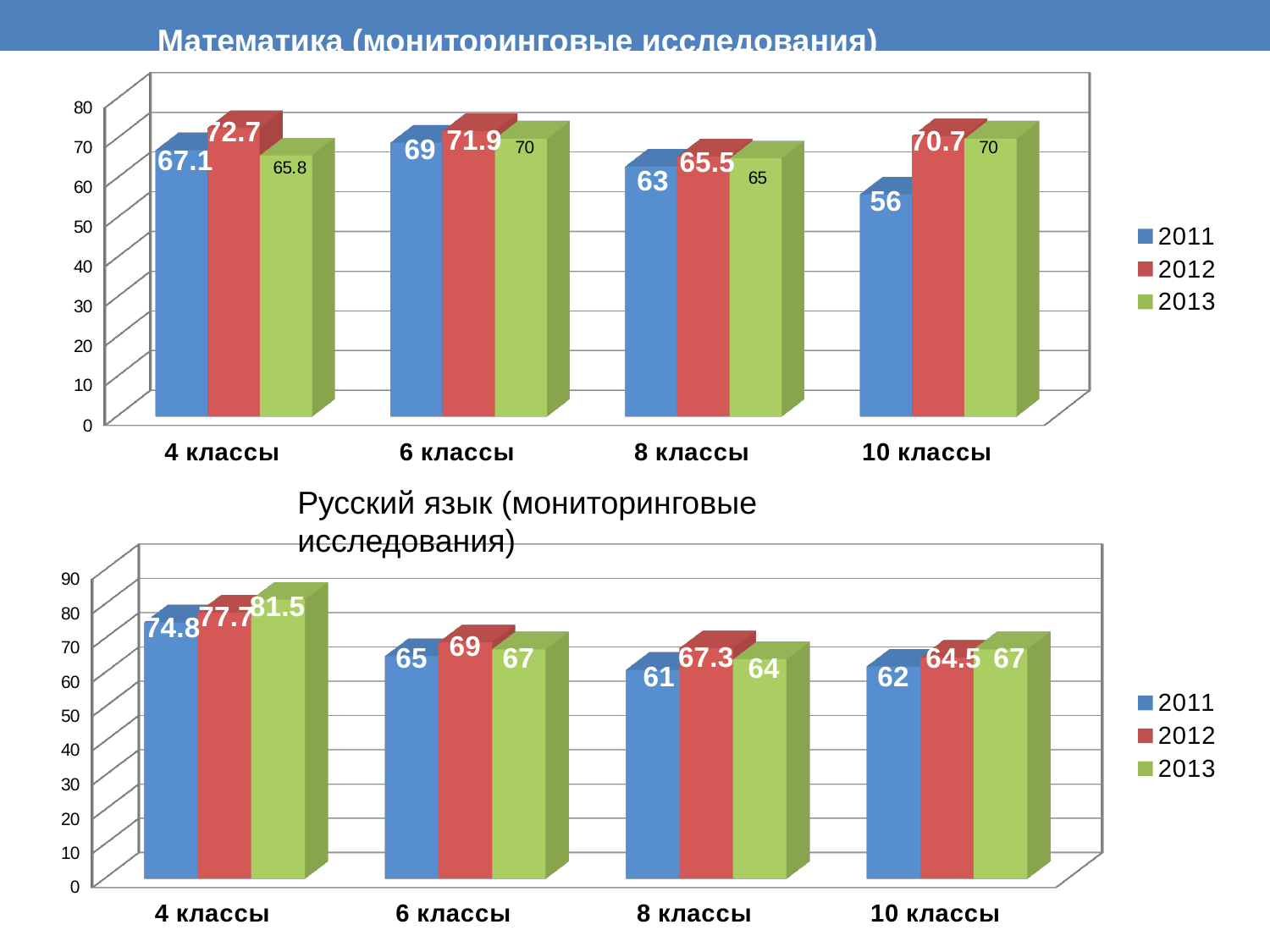
In the Русский язык (мониторинговые исследования) chart, which is larger in 6 классы: the 2012 value or the 2013 value? 2012 What type of chart is the Математика (мониторинговые исследования) chart? Bar chart In the Русский язык (мониторинговые исследования) chart, which category has the highest value for 2013? 4 классы In the Математика (мониторинговые исследования) chart, what is the value for 2011 in 10 классы? 56 In the Русский язык (мониторинговые исследования) chart, what is the difference between the 2013 and 2011 values in 4 классы? 6.7 How many categories are shown on the x axis of the Русский язык (мониторинговые исследования) chart? 4 In the Математика (мониторинговые исследования) chart, what is the value for 2012 in 4 классы? 72.7 In the Русский язык (мониторинговые исследования) chart, what is the value for 2013 in 4 классы? 81.5 In the Русский язык (мониторинговые исследования) chart, what is the value for 2012 in 8 классы? 67.3 In the Математика (мониторинговые исследования) chart, what is the difference between the 2012 and 2011 values in 10 классы? 14.7 In the Математика (мониторинговые исследования) chart, which category has the lowest value for 2011? 10 классы In the Математика (мониторинговые исследования) chart, how many series does the legend list? 3